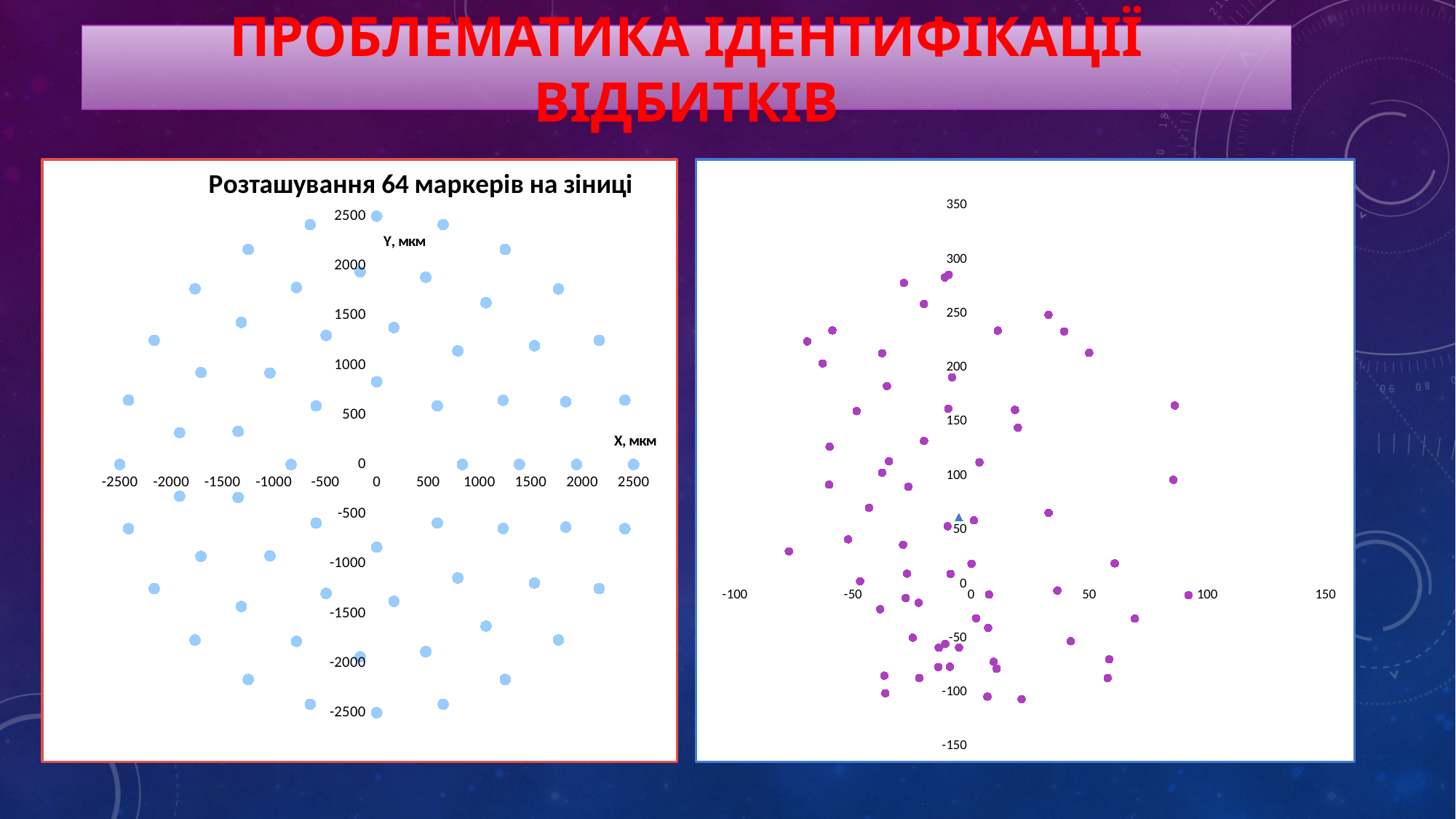
What is the label of the horizontal axis in the left chart? X, мкм In the right chart, is the x value of the rightmost purple marker greater or less than 50? greater In the left chart, is the x value of the leftmost marker greater or less than -2000? less In the right chart, is the y value of the blue triangle marker greater or less than 100? less What is the title of the left chart? Розташування 64 маркерів на зіниці According to its title, how many markers are plotted in the left chart? 64 What kind of chart is the left chart titled "Розташування 64 маркерів на зіниці"? scatter chart What kind of chart is the right chart with purple markers? scatter chart